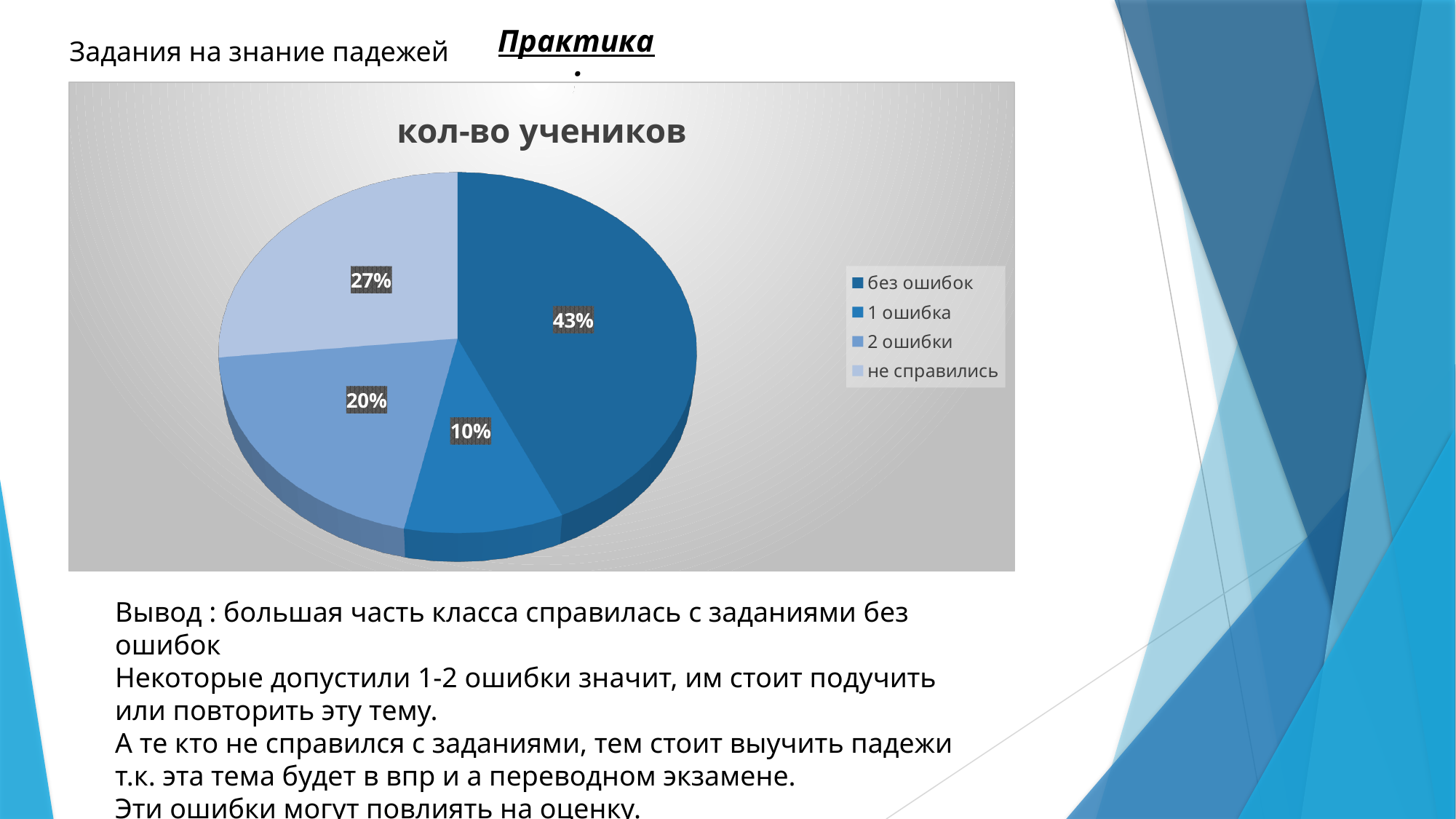
What percentage of the pie is labelled 'без ошибок'? 43% How many categories does the legend list? 4 What is the title of the chart? кол-во учеников What kind of chart is shown on the slide? pie chart Which is larger, the share for '2 ошибки' or the share for 'не справились'? не справились Which category has the smallest share of the pie? 1 ошибка Which category has the largest share of the pie? без ошибок What percentage of the pie is labelled '1 ошибка'? 10% What percentage of the pie is labelled 'не справились'? 27% What percentage of the pie is labelled '2 ошибки'? 20% What is the combined share of '1 ошибка' and '2 ошибки'? 30% What is the difference in percentage points between 'без ошибок' and 'не справились'? 16